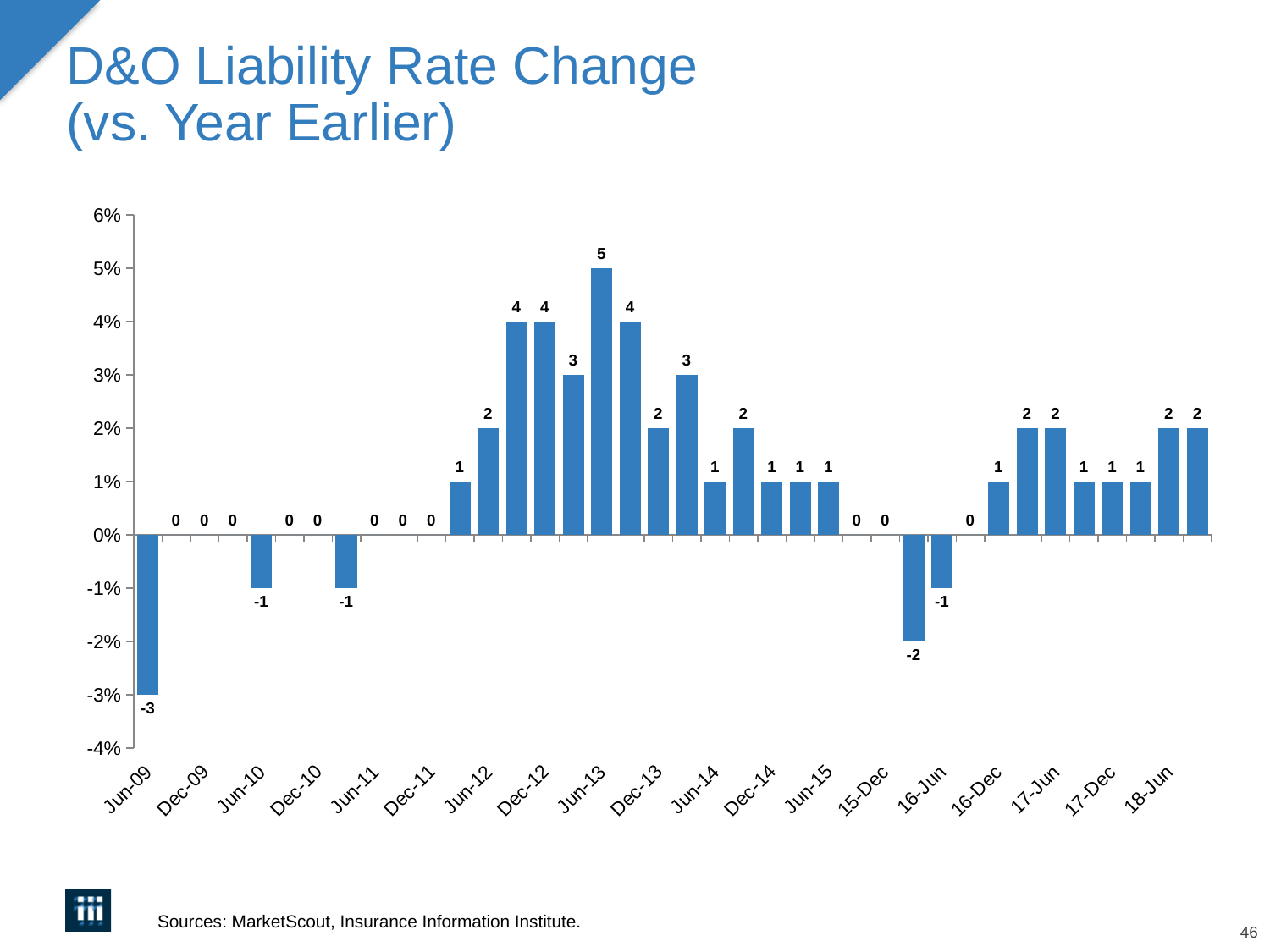
What is the highest value shown on the vertical axis? 6% What is the value of the bar for Jun-09? -3 What is the title of the chart? D&O Liability Rate Change (vs. Year Earlier) Which is larger, the value for Jun-09 or the value for Jun-13? Jun-13 What kind of chart is shown on the slide? bar chart Is the value for Jun-09 greater or less than -2%? less How many bars are plotted in the chart? 38 What is the lowest value labelled on any bar in the chart? -3 What is the difference between the highest bar value (5) and the lowest bar value (-3)? 8 What is the highest value labelled on any bar in the chart? 5 What is the value of the bar for Jun-13? 5 Is the value for Jun-13 greater or less than 4%? greater